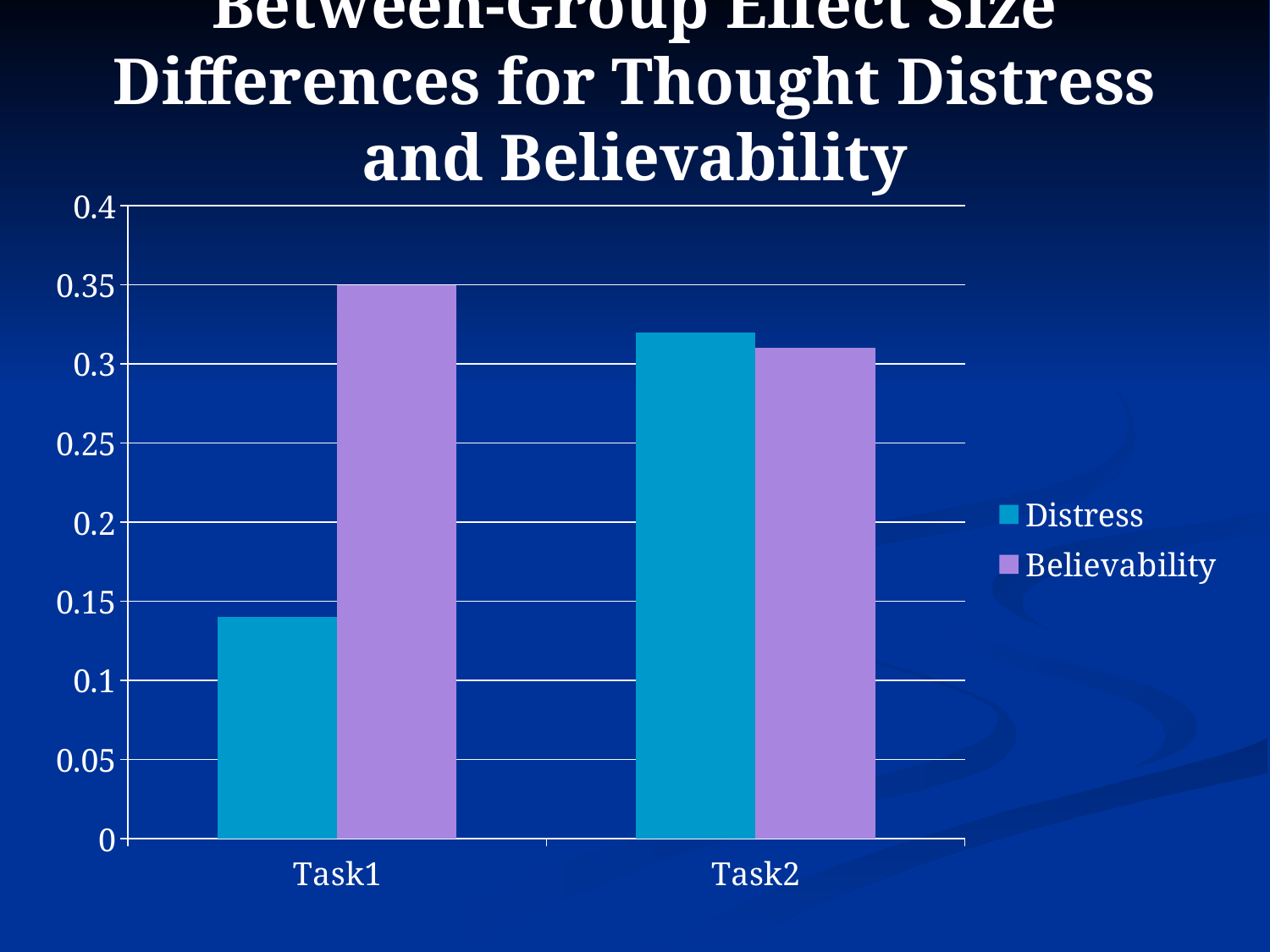
What kind of chart is shown on the slide? bar chart Which bar is the tallest in the chart? Believability for Task1 Is the Distress value for Task2 greater or less than 0.3? greater Does the Distress value rise or fall from Task1 to Task2? rise Is the Believability value for Task1 greater or less than 0.3? greater Is the Distress value for Task1 greater or less than 0.15? less How many task categories are shown on the x axis? 2 Which series is shown in purple in the legend? Believability For Task1, which is larger, Distress or Believability? Believability Which bar is the shortest in the chart? Distress for Task1 How many series does the legend list? 2